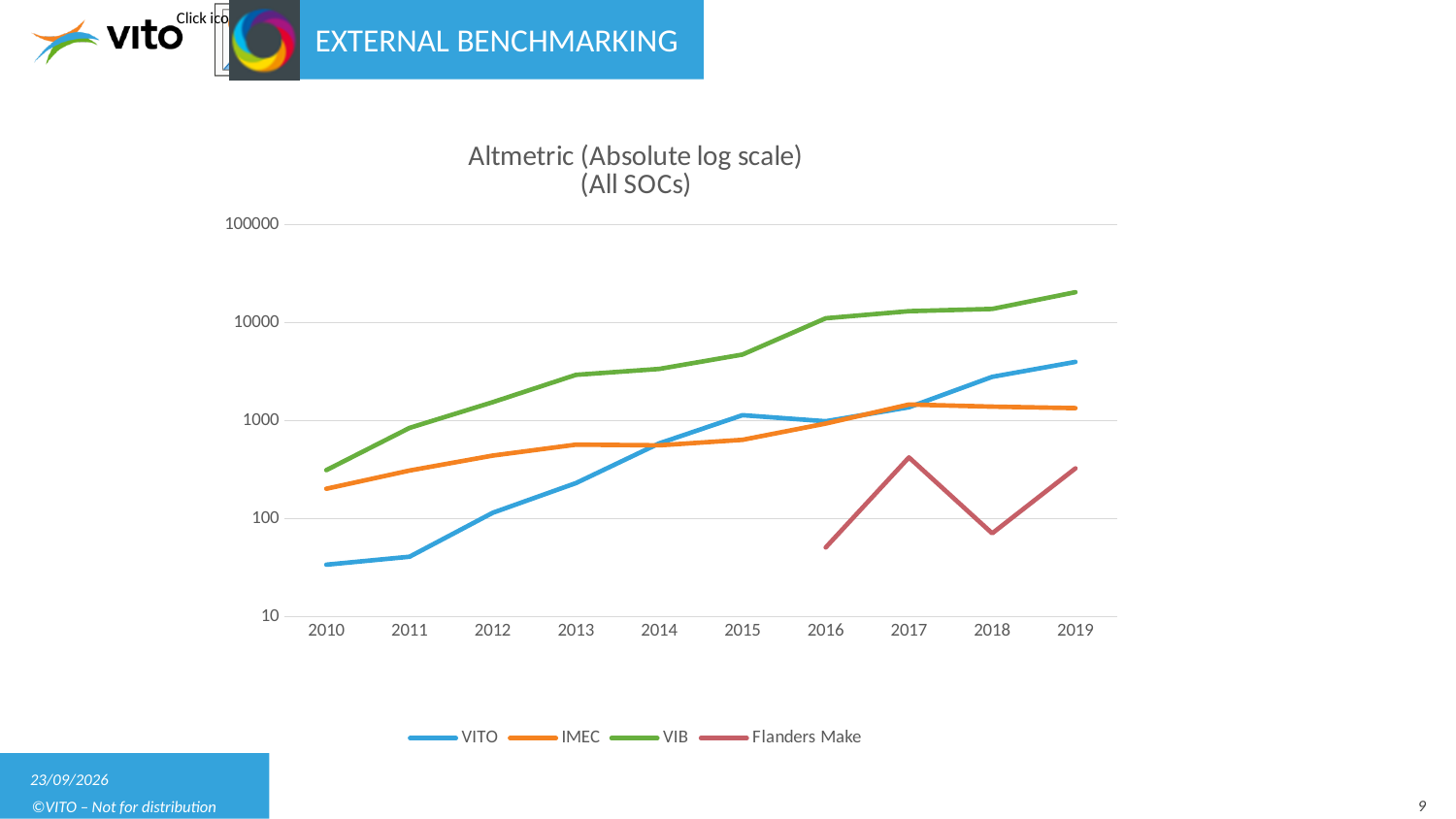
Is the value for VIB in 2019 greater or less than 10000? greater In 2019, which is larger, the value for VITO or the value for IMEC? VITO Is the value for Flanders Make in 2016 greater or less than 100? less Is the value for VITO in 2010 greater or less than 100? less What is the title of the chart? Altmetric (Absolute log scale) (All SOCs) Which series has the lowest value in 2019? Flanders Make Does the VIB line generally rise or fall from 2010 to 2019? rise How many years are shown on the x axis? 10 In 2010, which is larger, the value for VIB or the value for VITO? VIB How many series does the legend list? 4 Which series has the highest value in 2019? VIB What kind of chart is shown on the slide? line chart